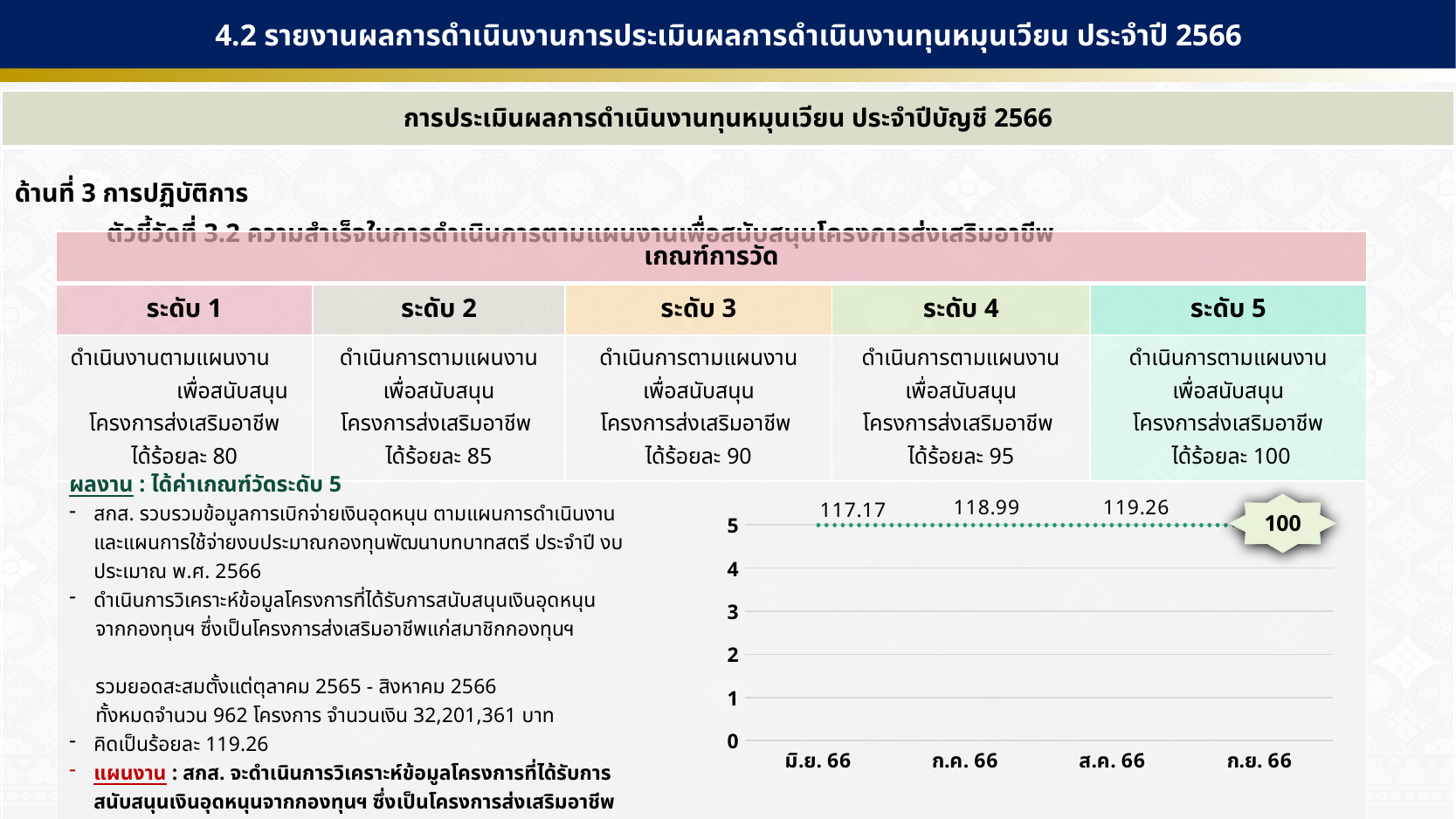
Which month has the highest data label in the chart? ส.ค. 66 What is the difference between the data labels for ส.ค. 66 and ก.ค. 66? 0.27 What is the data label shown for ก.ย. 66 in the chart? 100 What type of chart is shown at the bottom right of the slide? line chart Is the plotted level for มิ.ย. 66 greater or less than 4 on the y axis? greater How many months are shown on the x axis of the chart? 4 What is the highest value shown on the y axis of the chart? 5 What is the data label shown for ส.ค. 66 in the chart? 119.26 What is the data label shown for ก.ค. 66 in the chart? 118.99 What is the data label shown for มิ.ย. 66 in the chart? 117.17 Which month has the lowest data label in the chart? ก.ย. 66 Which has the larger data label, มิ.ย. 66 or ก.ค. 66? ก.ค. 66